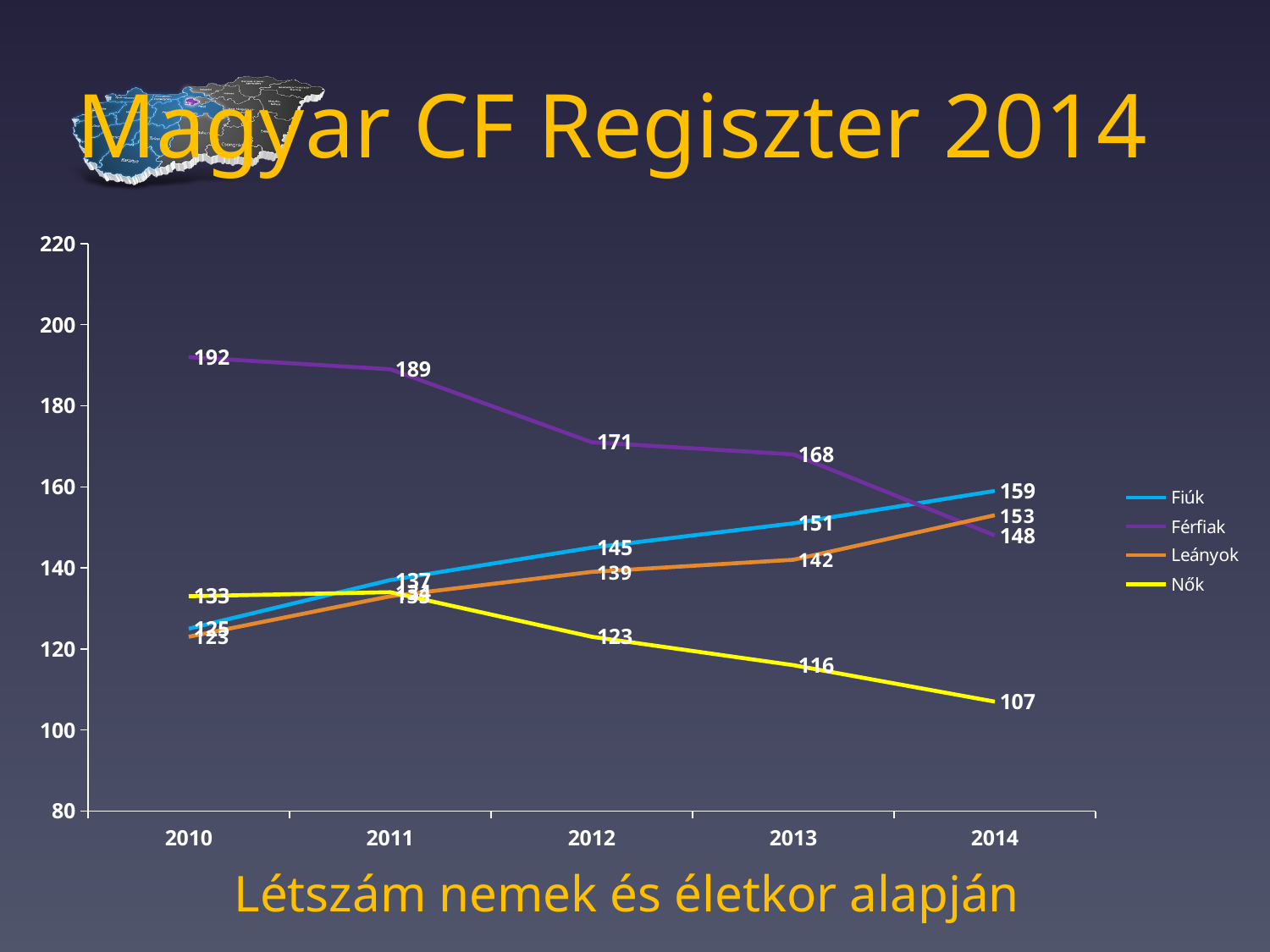
How many years are shown on the x axis? 5 By how much did the Férfiak value decrease from 2010 to 2014? 44 Which series has the highest value in 2010? Férfiak Do the values for Nők rise or fall from 2010 to 2014? fall Which series has the lowest value in 2014? Nők How many series does the legend list? 4 What kind of chart is shown on the slide? line chart What is the value for Nők in 2014? 107 What is the value for Fiúk in 2014? 159 What is the value for Férfiak in 2010? 192 What is the value for Leányok in 2013? 142 In 2014, which is larger: Fiúk or Férfiak? Fiúk